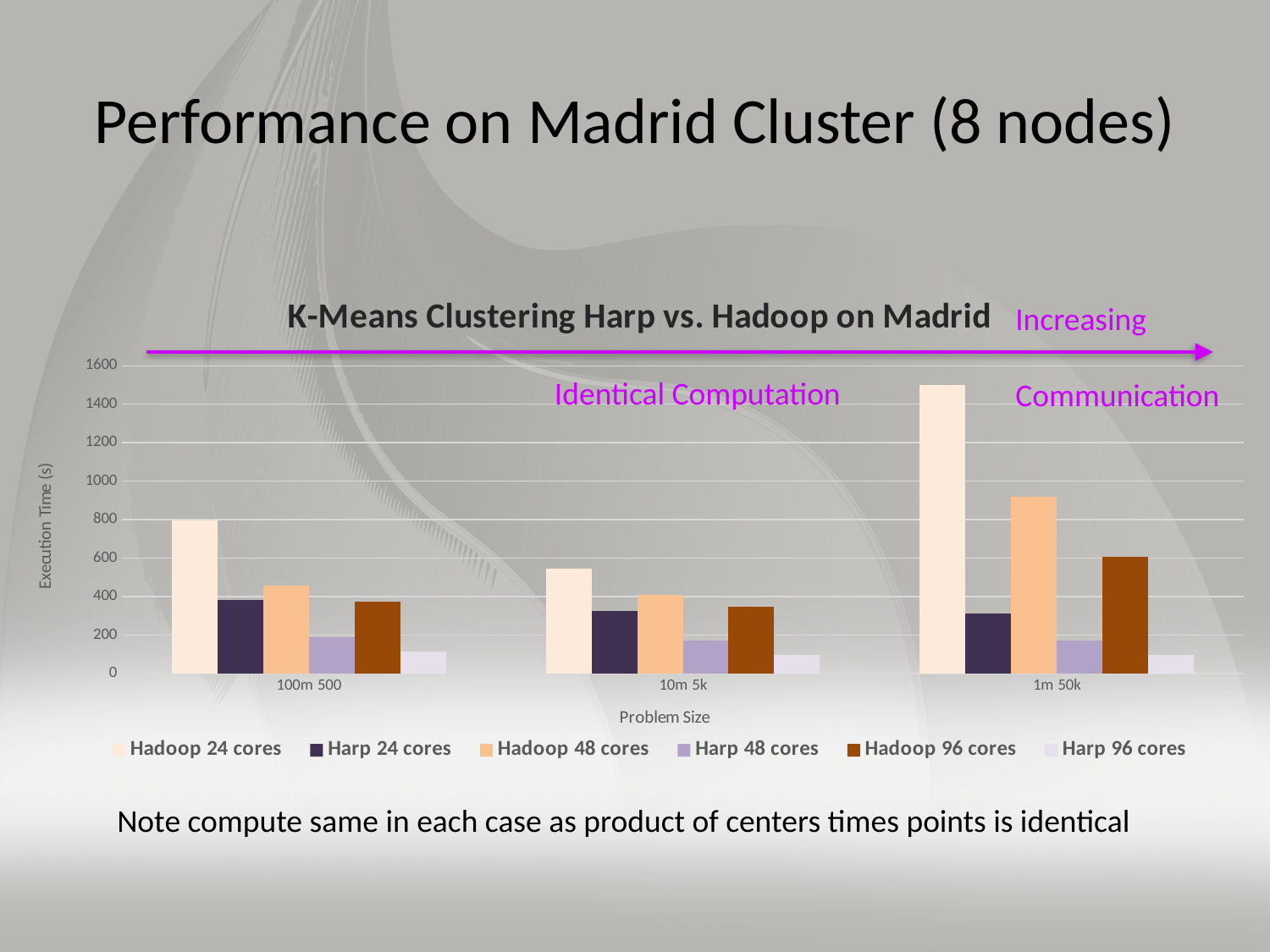
How many problem-size categories are shown on the x axis? 3 What kind of chart is shown on the slide? bar chart What is the title of the chart? K-Means Clustering Harp vs. Hadoop on Madrid Which series has the tallest bar in the 1m 50k category? Hadoop 24 cores In the 100m 500 category, which is larger: Hadoop 24 cores or Harp 24 cores? Hadoop 24 cores Is the value for Hadoop 24 cores at 1m 50k greater or less than 1400? greater Is the value for Hadoop 48 cores at 1m 50k greater or less than 800? greater Is the value for Hadoop 24 cores at 10m 5k greater or less than 400? greater Which series has the shortest bar in the 1m 50k category? Harp 96 cores How many series does the chart legend list? 6 What is the label of the vertical axis? Execution Time (s)